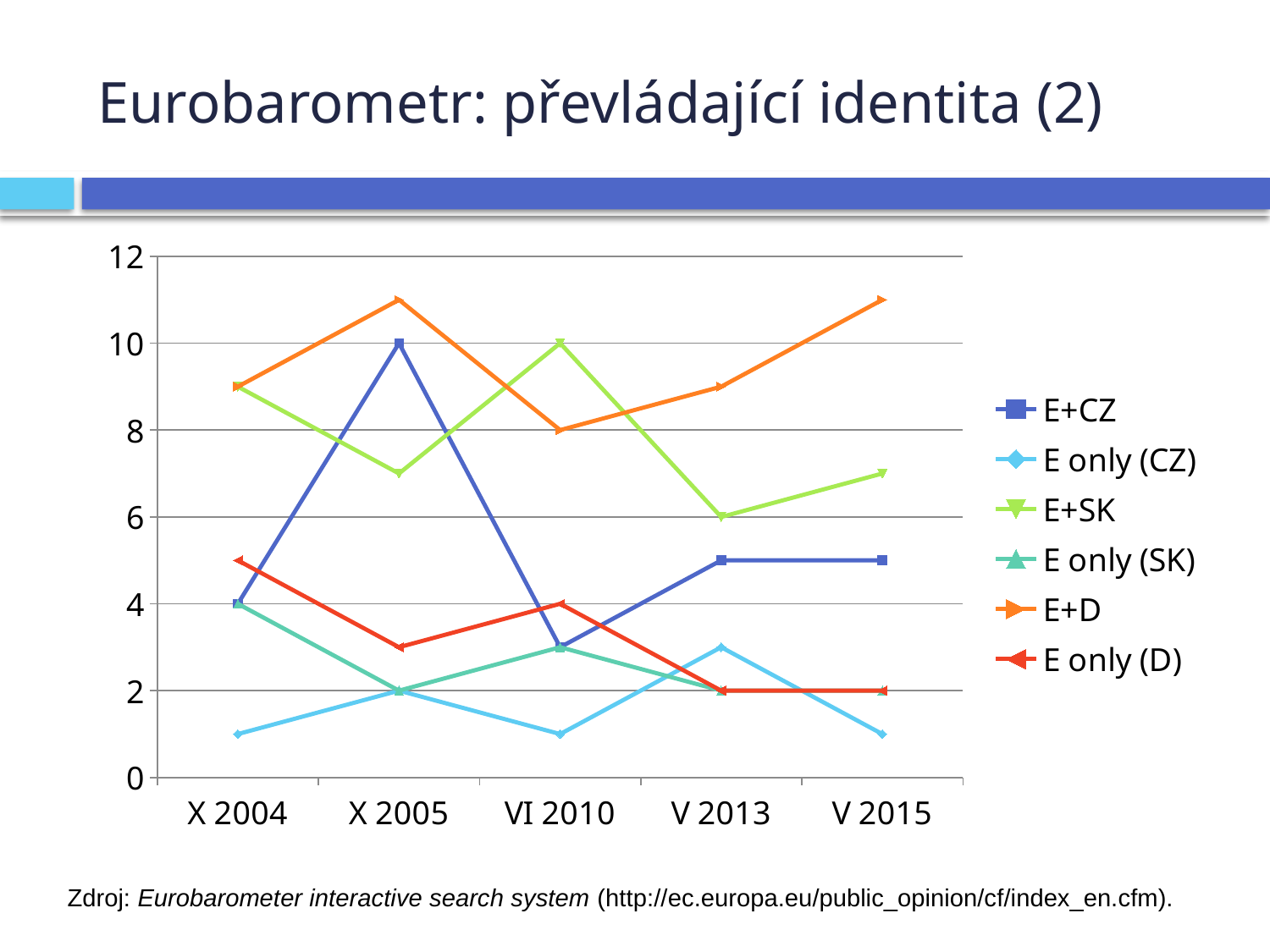
Does the E+D series rise or fall from VI 2010 to V 2015? rise Is the value for E+D at V 2015 greater or less than 10? greater Which series has the highest value at V 2015? E+D What is the difference between the E+CZ value at X 2005 and at X 2004? 6 What is the value for E+D at VI 2010? 8 How many time points are shown on the x axis? 5 Which series has the lowest value at X 2004? E only (CZ) What is the value for E+CZ at X 2005? 10 What is the value for E+SK at VI 2010? 10 At X 2005, which is larger, E+CZ or E+SK? E+CZ How many series does the legend list? 6 What kind of chart is shown on the slide? line chart